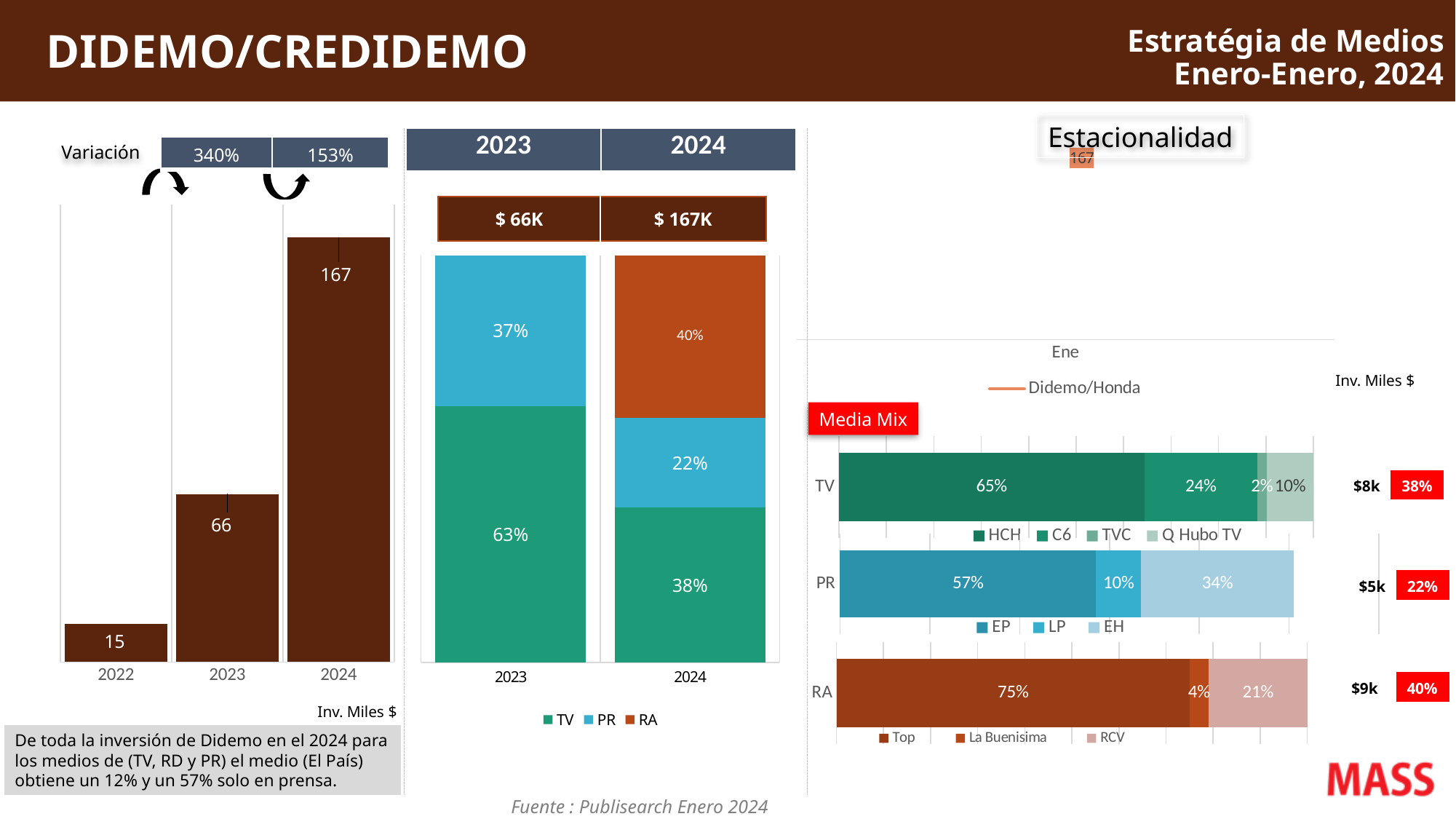
In the bar chart on the left of the slide, how many years are shown? 3 In the stacked bar chart in the middle of the slide (2023 vs 2024), which is larger: the PR share in 2023 or the PR share in 2024? 2023 In the bar chart on the left of the slide, do the values rise or fall from 2022 to 2024? rise In the stacked bar chart in the middle of the slide (2023 vs 2024), what is the RA share in 2024? 40% In the stacked bar chart in the middle of the slide (2023 vs 2024), how many series does the legend list? 3 In the bar chart on the left of the slide, what is the difference between the 2024 and 2023 values? 101 In the bar chart on the left of the slide, which year has the highest value? 2024 In the Media Mix chart, what is the share for HCH in the TV bar? 65% In the Media Mix chart, what is the share for EH in the PR bar? 34% In the bar chart on the left of the slide, what is the value for 2022? 15 In the bar chart on the left of the slide, what is the value for 2024? 167 In the stacked bar chart in the middle of the slide (2023 vs 2024), what is the TV share in 2023? 63%